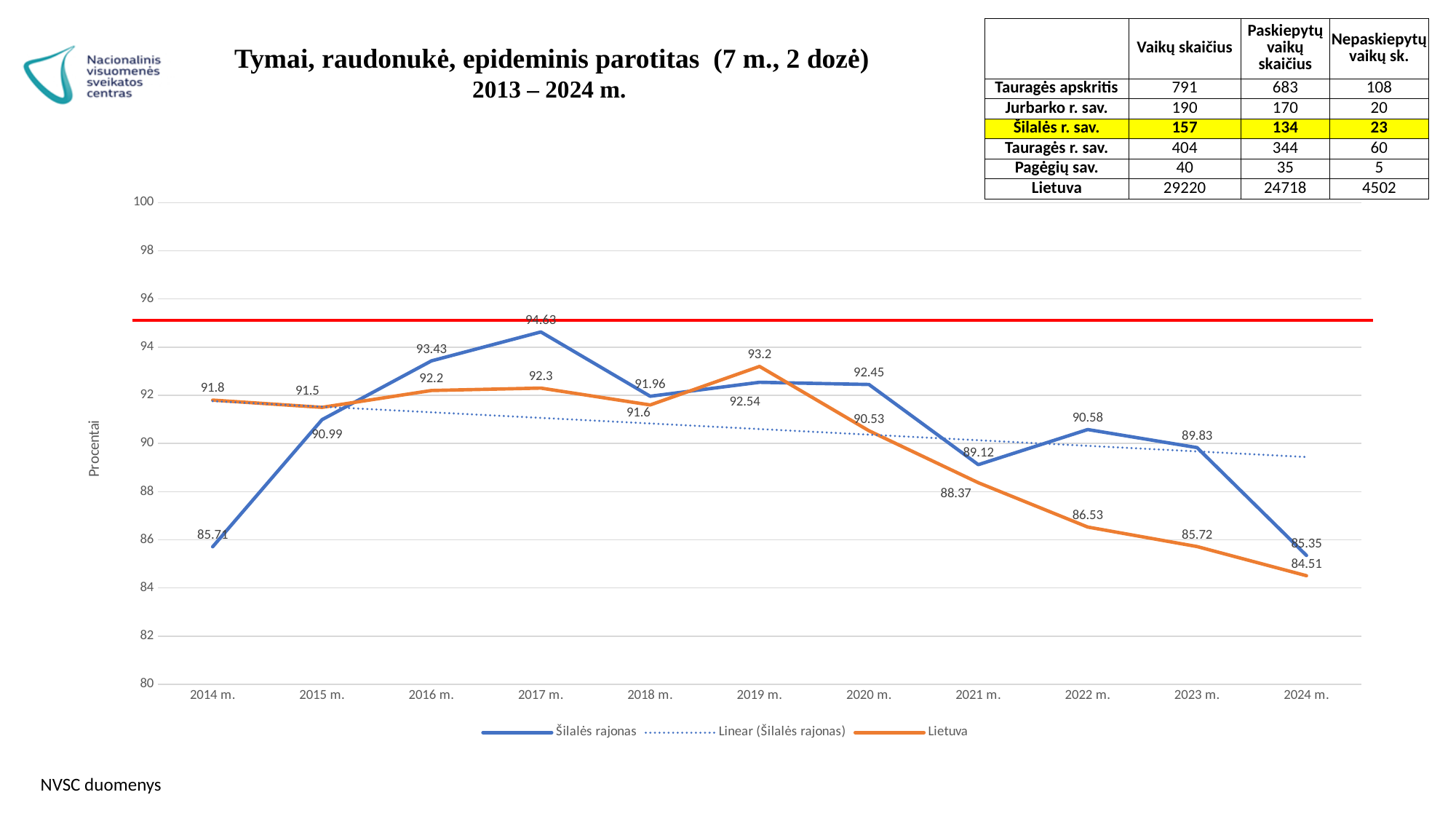
What kind of chart is shown on the slide? line chart Which series has the larger value in 2014 m., Šilalės rajonas or Lietuva? Lietuva What is the value for Šilalės rajonas in 2024 m.? 85.35 What is the value for Lietuva in 2019 m.? 93.2 Does the Lietuva series rise or fall from 2019 m. to 2024 m.? fall What is the value for Šilalės rajonas in 2017 m.? 94.63 Is the value for Lietuva in 2022 m. greater or less than 88? less How many entries does the chart legend list? 3 In which year does the Šilalės rajonas series reach its highest value? 2017 m. How many years are shown on the x axis of the chart? 11 In which year does the Lietuva series have its lowest value? 2024 m. What is the difference between Šilalės rajonas and Lietuva in 2017 m.? 2.33